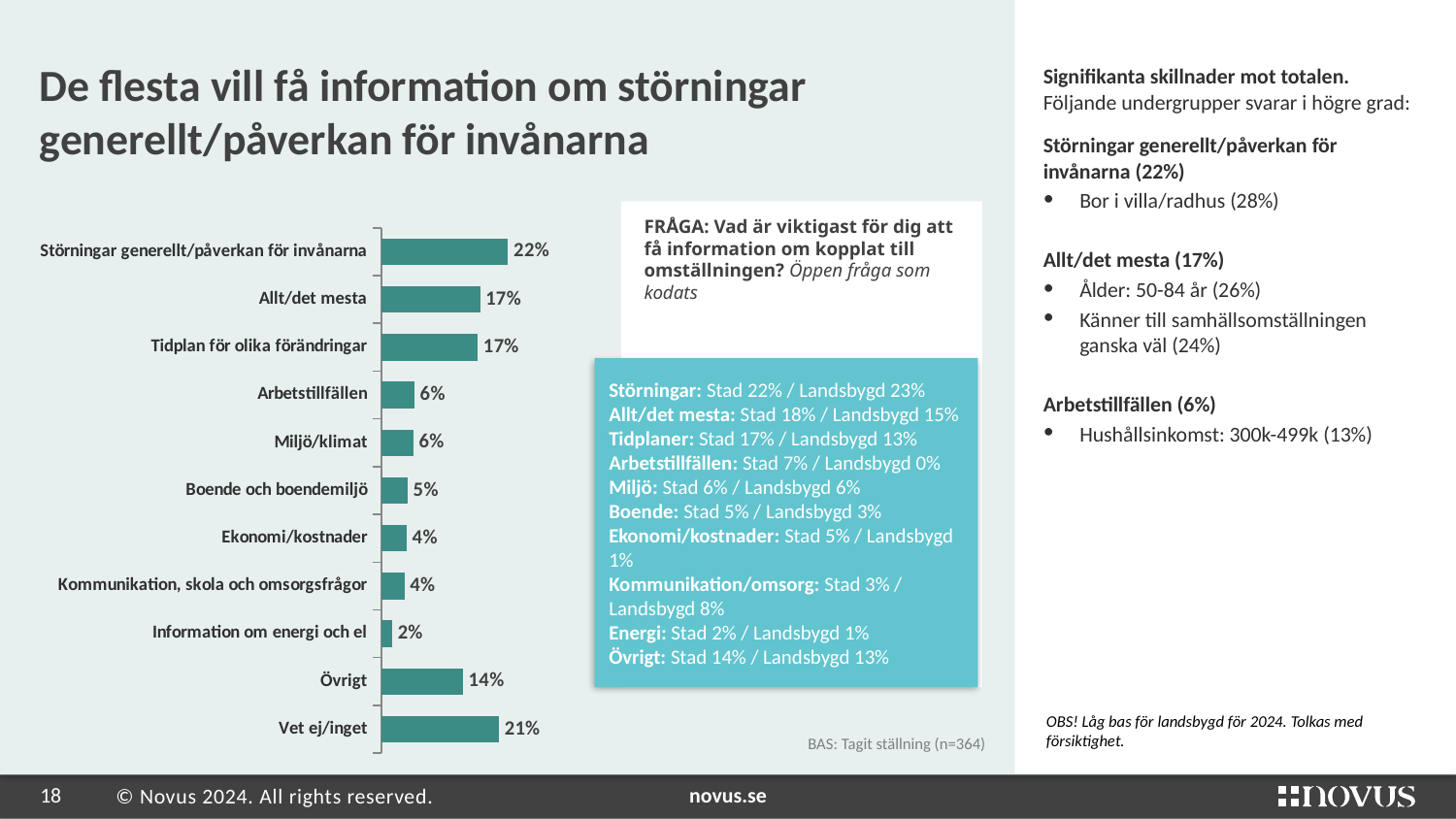
Which category has the lowest value? Information om energi och el How many categories are shown in the chart? 11 What is the value for Vet ej/inget? 21% What is the difference between the values for Allt/det mesta and Arbetstillfällen? 11 percentage points Which category has the highest value? Störningar generellt/påverkan för invånarna What is the value for Övrigt? 14% What is the value for Information om energi och el? 2% What is the value for Störningar generellt/påverkan för invånarna? 22% What is the value for Boende och boendemiljö? 5% What kind of chart is shown on the slide? Bar chart Which is larger, the value for Övrigt or the value for Vet ej/inget? Vet ej/inget What is the base (n) stated below the chart? n=364